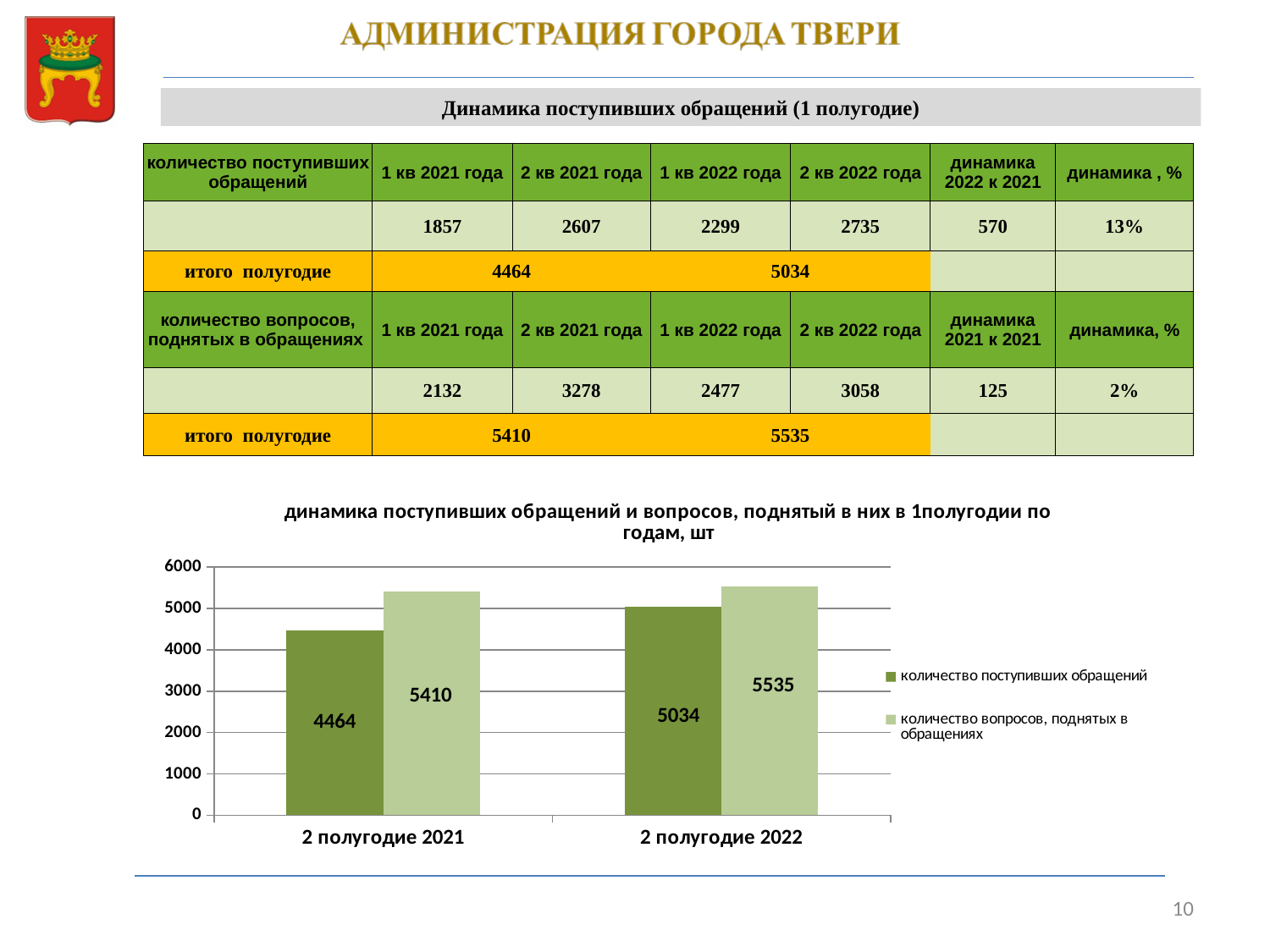
What is the value of "количество вопросов, поднятых в обращениях" for "2 полугодие 2022" in the chart? 5535 What is the value of "количество вопросов, поднятых в обращениях" for "2 полугодие 2021" in the chart? 5410 In the chart, for "2 полугодие 2021", which is larger: "количество поступивших обращений" or "количество вопросов, поднятых в обращениях"? количество вопросов, поднятых в обращениях In the chart, which category has the higher value for "количество поступивших обращений"? 2 полугодие 2022 Does the value of "количество поступивших обращений" rise or fall from "2 полугодие 2021" to "2 полугодие 2022" in the chart? rise What is the value of "количество поступивших обращений" for "2 полугодие 2021" in the chart? 4464 How many series does the chart legend list? 2 What is the value of "количество поступивших обращений" for "2 полугодие 2022" in the chart? 5034 How many categories are shown on the x axis of the chart? 2 What is the difference between "количество поступивших обращений" in "2 полугодие 2022" and in "2 полугодие 2021" in the chart? 570 What is the difference between "количество вопросов, поднятых в обращениях" in "2 полугодие 2022" and in "2 полугодие 2021" in the chart? 125 What type of chart is shown on the slide? bar chart